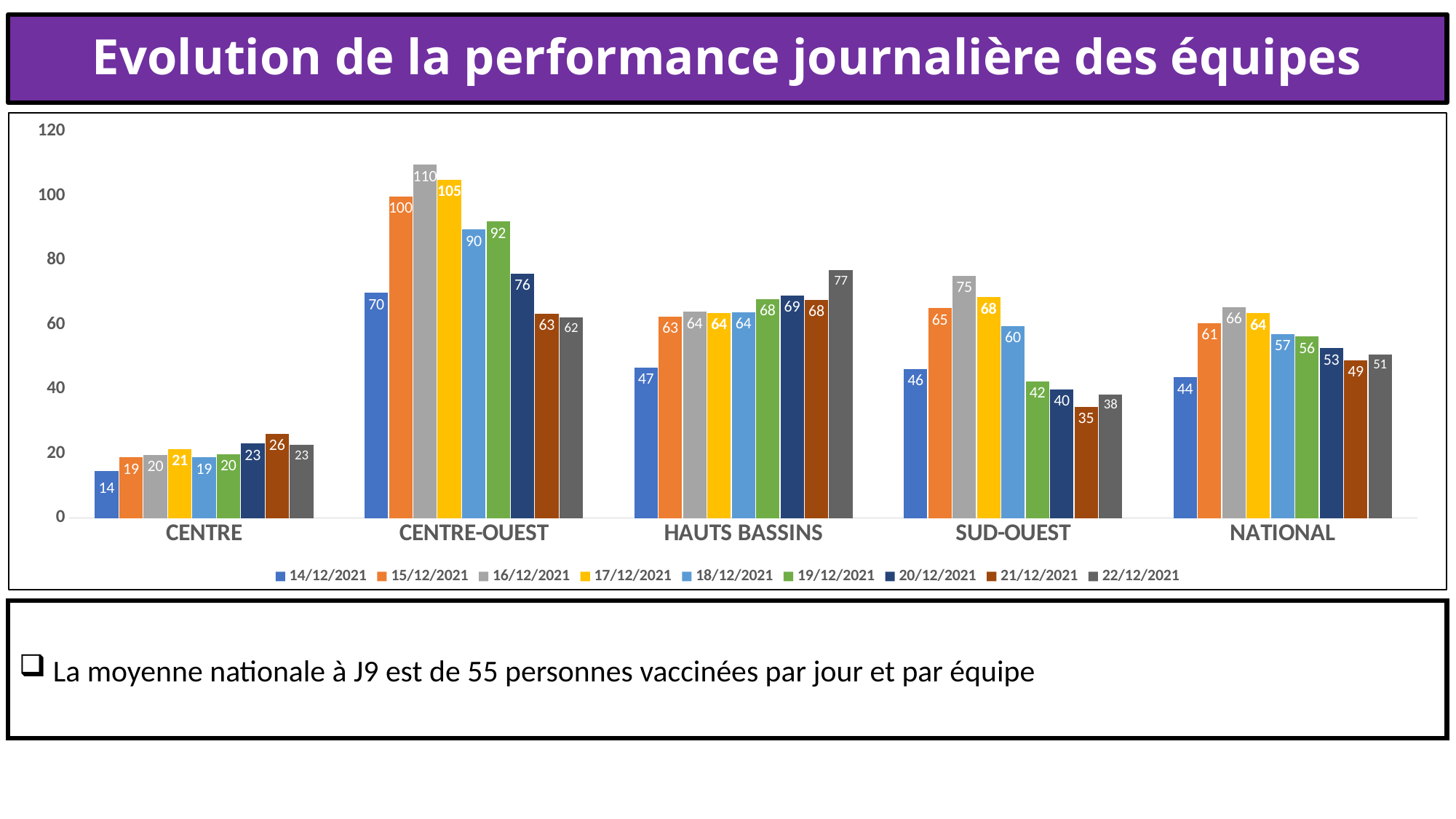
Which is larger: the HAUTS BASSINS value on 22/12/2021 or the SUD-OUEST value on 22/12/2021? HAUTS BASSINS Which region has the highest value on 14/12/2021? CENTRE-OUEST What is the value for SUD-OUEST on 21/12/2021? 35 What is the value for NATIONAL on 22/12/2021? 51 What is the value for CENTRE-OUEST on 16/12/2021? 110 What is the difference between the CENTRE-OUEST values on 16/12/2021 and 22/12/2021? 48 How many series does the legend list? 9 Is the value for CENTRE-OUEST on 17/12/2021 greater or less than 100? greater Which region has the lowest value on 22/12/2021? CENTRE How many regions (categories) are shown on the x axis? 5 What kind of chart is shown on the slide? bar chart Do the values for HAUTS BASSINS generally rise or fall from 14/12/2021 to 22/12/2021? rise